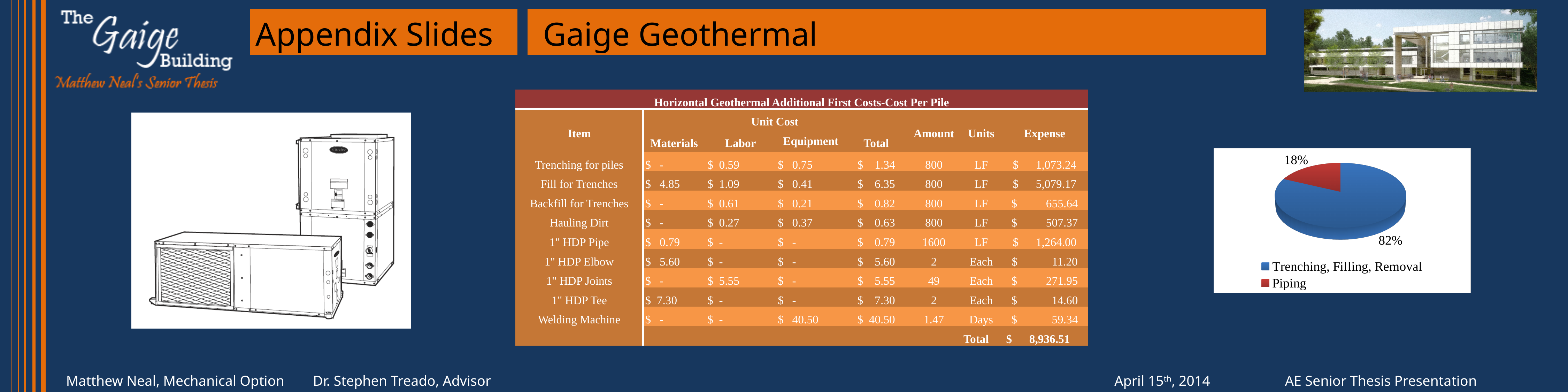
Which category has the smallest slice in the pie chart? Piping What share of the pie chart does Piping represent? 18% How many entries does the pie chart's legend list? 2 What colour is the Piping slice in the pie chart? Red Which is larger in the pie chart, Piping or Trenching, Filling, Removal? Trenching, Filling, Removal By how many percentage points does the Trenching, Filling, Removal slice exceed the Piping slice? 64 Which category has the largest slice in the pie chart? Trenching, Filling, Removal What colour is the Trenching, Filling, Removal slice in the pie chart? Blue What share of the pie chart does Trenching, Filling, Removal represent? 82% What kind of chart is shown on the right side of the slide? Pie chart How many slices does the pie chart have? 2